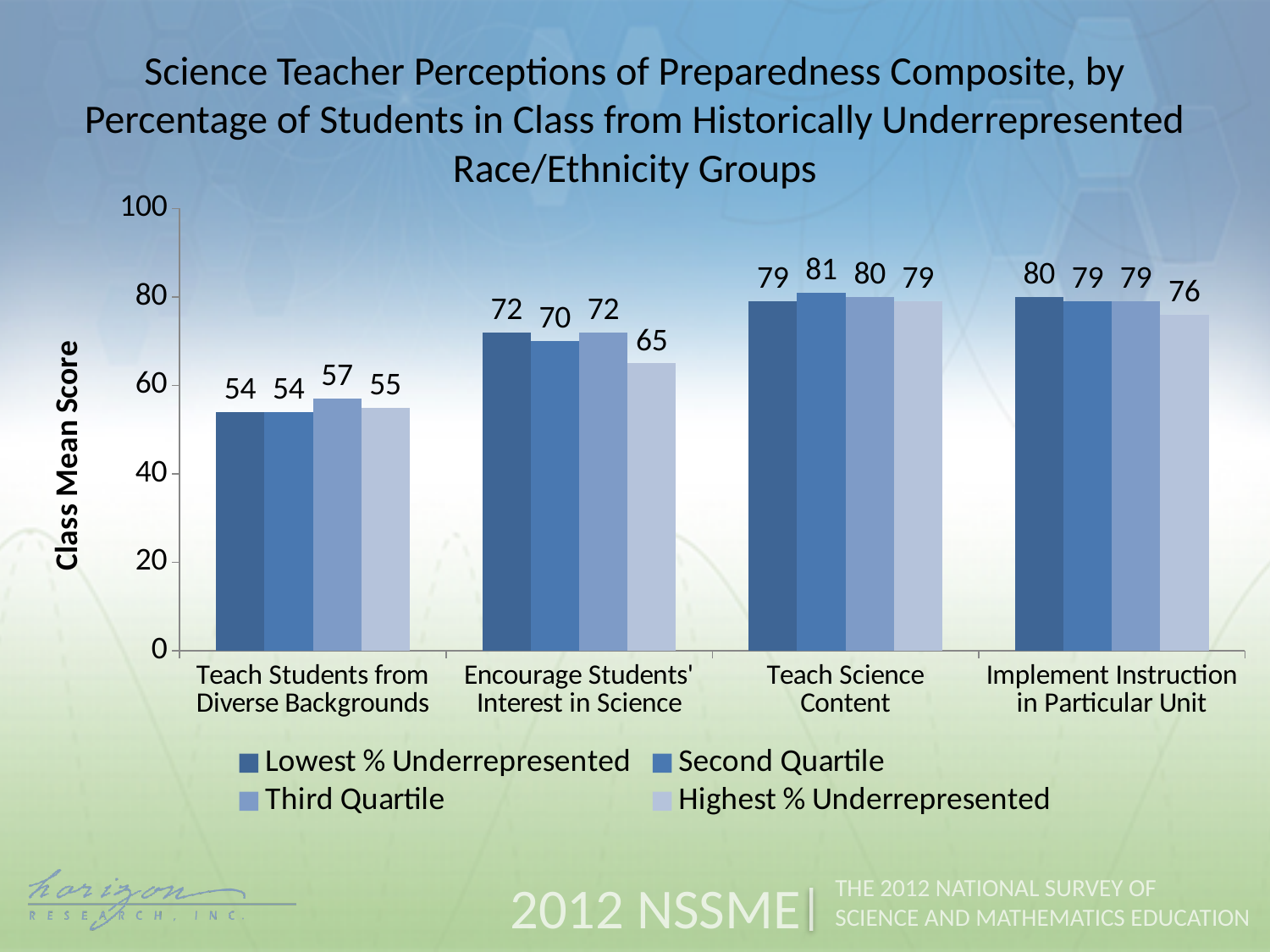
What is the value for Highest % Underrepresented in the Implement Instruction in Particular Unit category? 76 Which series has the lowest value in the Encourage Students' Interest in Science category? Highest % Underrepresented How many categories are shown on the x axis? 4 What is the difference between the Third Quartile and Highest % Underrepresented values in the Encourage Students' Interest in Science category? 7 Which series has the highest value in the Teach Students from Diverse Backgrounds category? Third Quartile Which is larger: the Lowest % Underrepresented value for Teach Science Content or for Implement Instruction in Particular Unit? Implement Instruction in Particular Unit How many series does the legend list? 4 What is the label of the y axis? Class Mean Score What kind of chart is shown on the slide? Bar chart What is the value for Second Quartile in the Teach Science Content category? 81 What is the value for Lowest % Underrepresented in the Teach Students from Diverse Backgrounds category? 54 What is the value for Highest % Underrepresented in the Encourage Students' Interest in Science category? 65